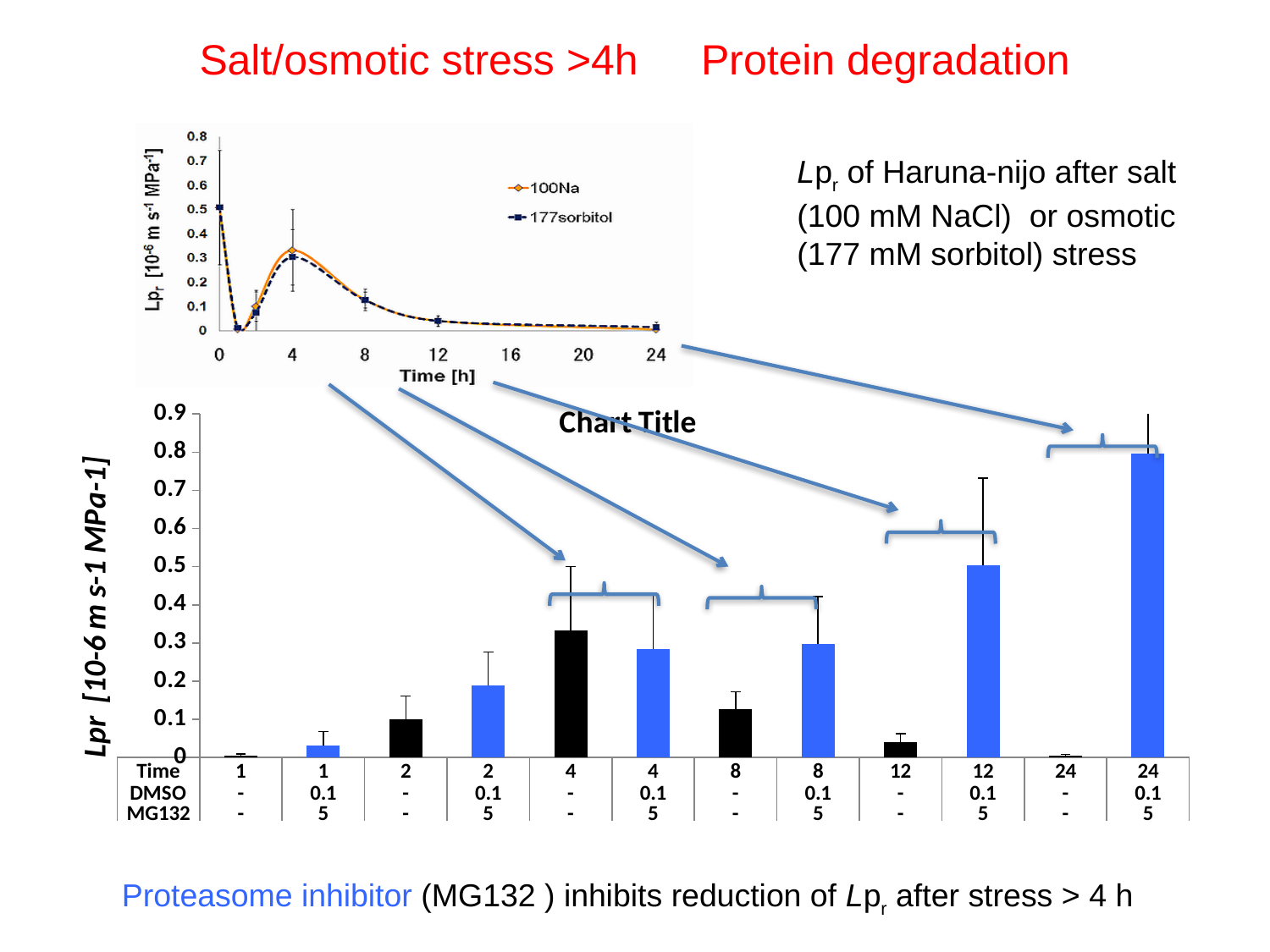
In the small line chart at the top left, what is the x-axis label? Time [h] What kind of chart is the small chart at the top left of the slide? line chart In the bar chart titled "Chart Title", which bar is the highest? 24 h with MG132 (DMSO 0.1, MG132 5) In the small line chart at the top left, what are the two legend entries? 100Na and 177sorbitol In the bar chart titled "Chart Title", how many bars are plotted? 12 In the bar chart titled "Chart Title", is the bar for 12 h with MG132 (DMSO 0.1, MG132 5) greater or less than 0.4? greater In the bar chart titled "Chart Title", is the bar for 24 h with MG132 (DMSO 0.1, MG132 5) greater or less than 0.7? greater In the small line chart at the top left, how many series does the legend list? 2 In the bar chart titled "Chart Title", at 8 h, which bar is larger: the one without MG132 or the one with MG132 (DMSO 0.1, MG132 5)? with MG132 In the small line chart at the top left, do the Lpr values rise or fall between 4 h and 24 h? fall What kind of chart is the large chart at the bottom of the slide (titled "Chart Title")? bar chart In the small line chart at the top left, is the Lpr value at 0 h greater or less than 0.4? greater